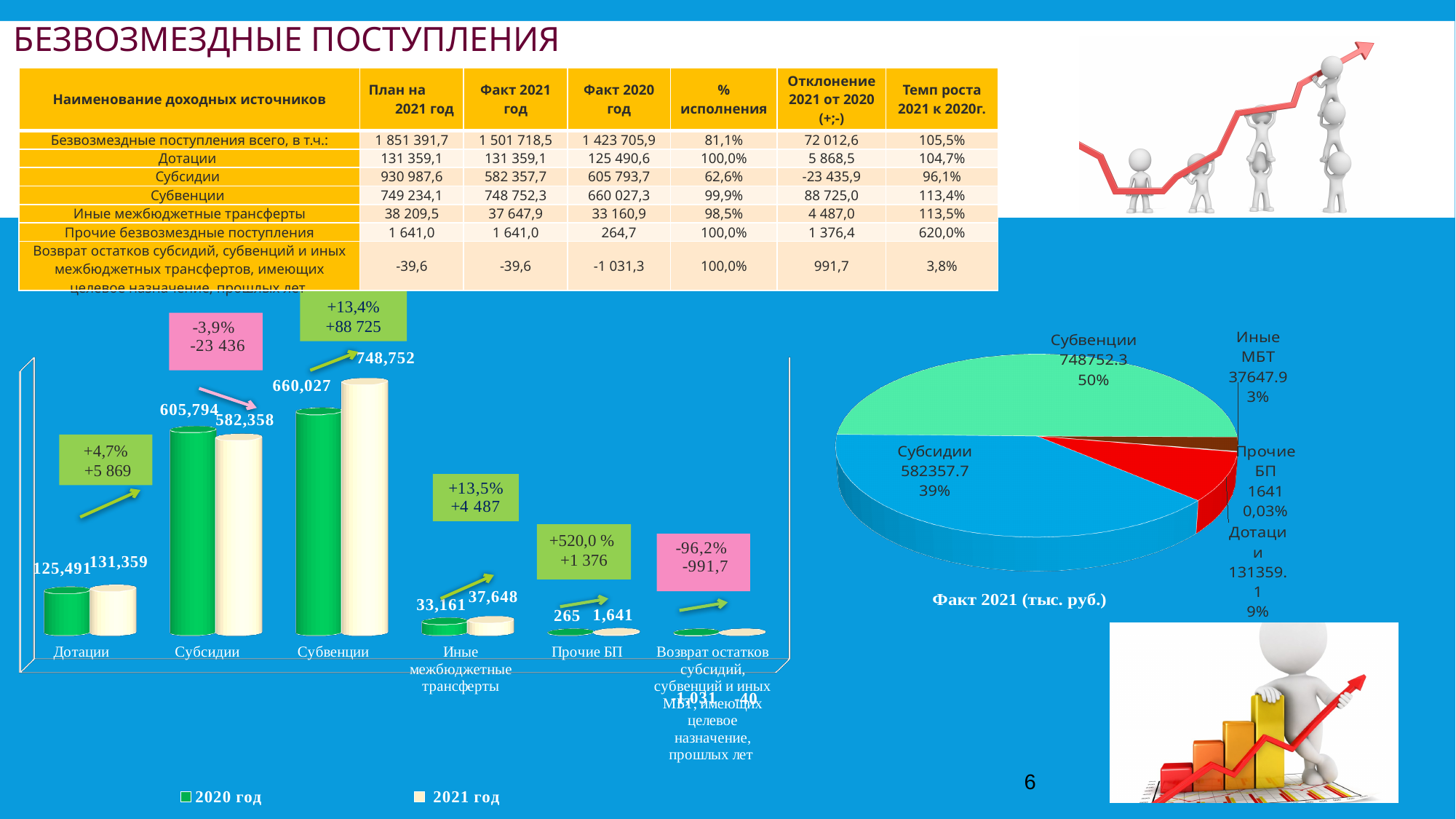
What type of chart is shown on the left side of the slide? bar chart In the bar chart on the left, what is the 2021 год value for Дотации? 131,359 In the bar chart on the left, what is the difference between the 2021 год and 2020 год values for Иные межбюджетные трансферты? 4,487 How many series does the legend of the bar chart on the left list? 2 In the pie chart titled 'Факт 2021 (тыс. руб.)', what share does Субвенции have? 50% In the bar chart on the left, is the 2021 год value for Субсидии larger or smaller than its 2020 год value? smaller How many slices does the pie chart titled 'Факт 2021 (тыс. руб.)' have? 5 In the bar chart on the left, what is the 2021 год value for Субвенции? 748,752 In the bar chart on the left, which category has the highest 2021 год value? Субвенции In the pie chart titled 'Факт 2021 (тыс. руб.)', which slice is the smallest? Прочие БП In the bar chart on the left, what is the 2020 год value for Субсидии? 605,794 In the pie chart titled 'Факт 2021 (тыс. руб.)', what is the value for Субсидии? 582357.7